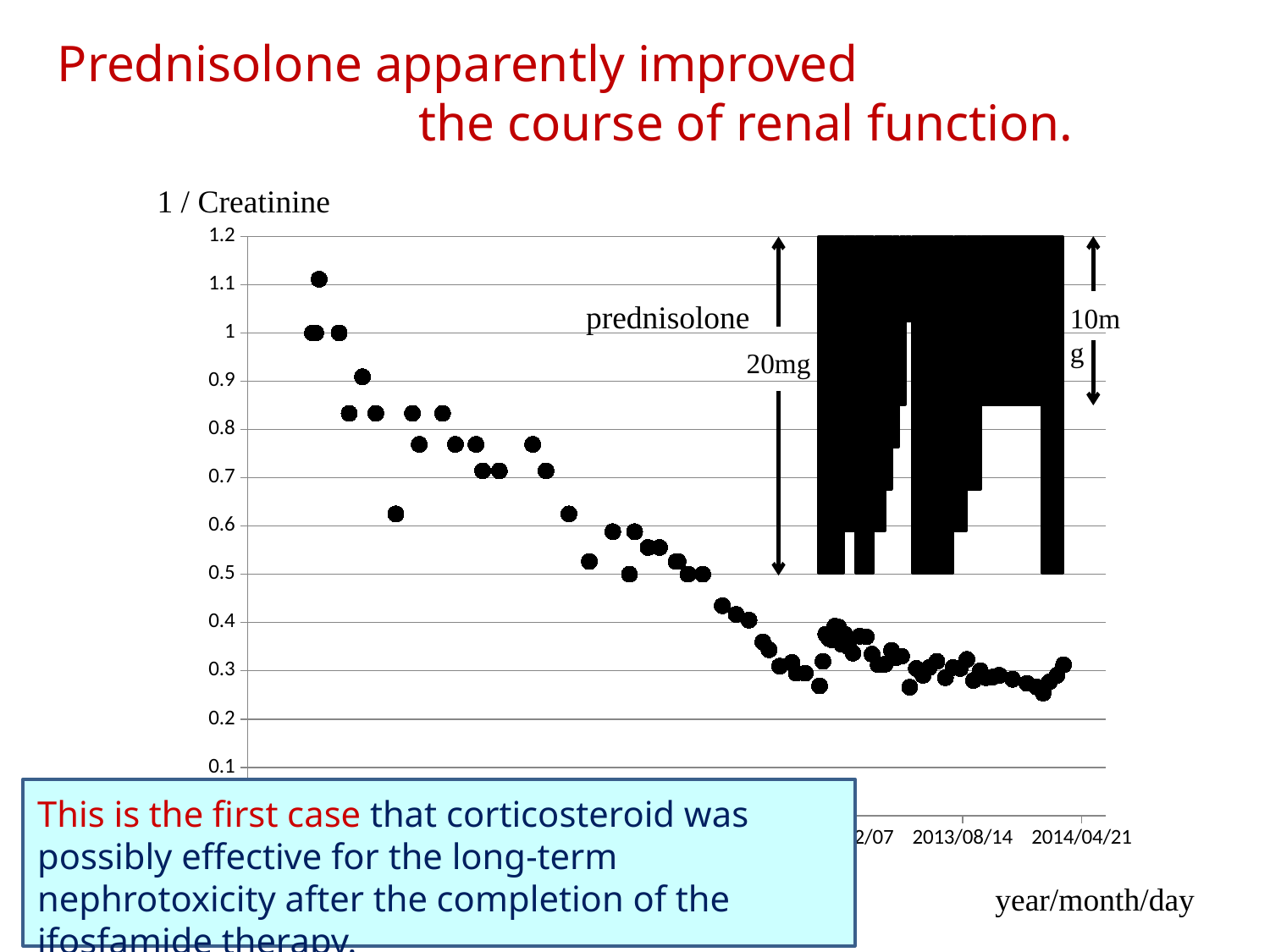
What is the lowest tick value shown on the vertical axis? 0.1 What is the lower prednisolone dose annotated on the chart? 10mg What is the last date label shown on the horizontal axis? 2014/04/21 What is the higher prednisolone dose annotated on the chart? 20mg Are the plotted values at the start of the series larger or smaller than those at the end of the series? larger What is the label of the horizontal axis of the chart? year/month/day What is the highest tick value shown on the vertical axis? 1.2 Are the plotted values around 2013/08/14 greater or less than 0.5? less Do the plotted 1 / Creatinine values rise or fall over time along the x axis? fall Is the highest plotted 1 / Creatinine value greater or less than 1? greater What kind of chart is shown on the slide? scatter chart What is the label of the vertical axis of the chart? 1 / Creatinine